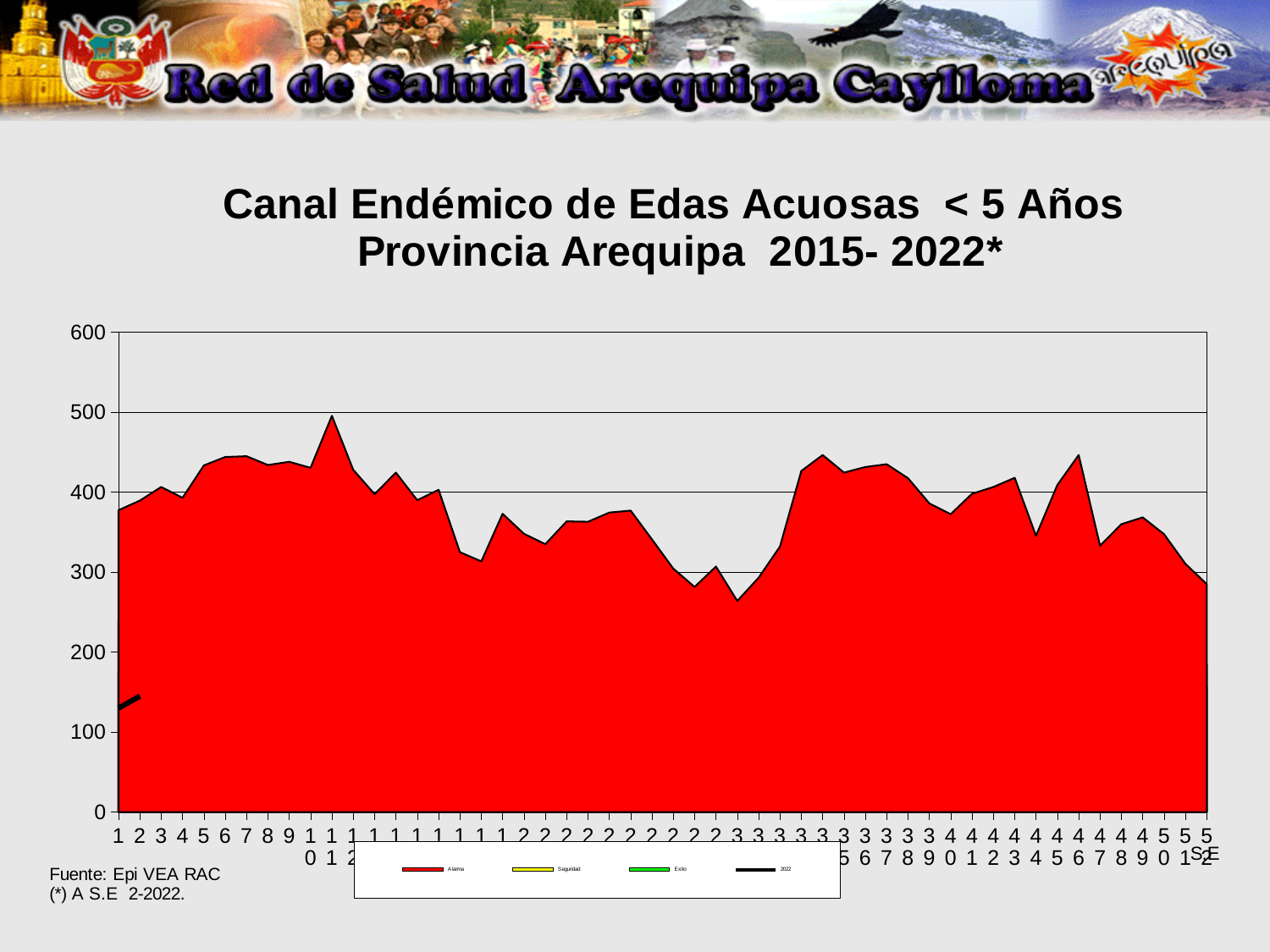
Which is larger, the red 'Alarma' value at week 11 or at week 32? Week 11 At which epidemiological week does the red 'Alarma' area reach its highest value? 11 Is the value of the red 'Alarma' area at week 11 greater or less than 400? greater How many series does the legend list? 4 Is the value of the red 'Alarma' area at week 36 greater or less than 400? greater What is the title of the chart? Canal Endémico de Edas Acuosas < 5 Años Provincia Arequipa 2015- 2022* Is the value of the red 'Alarma' area at week 32 greater or less than 300? greater What kind of chart is shown on the slide? Area chart What is the highest value shown on the y axis? 600 What colour is the 'Alarma' series in the chart? Red